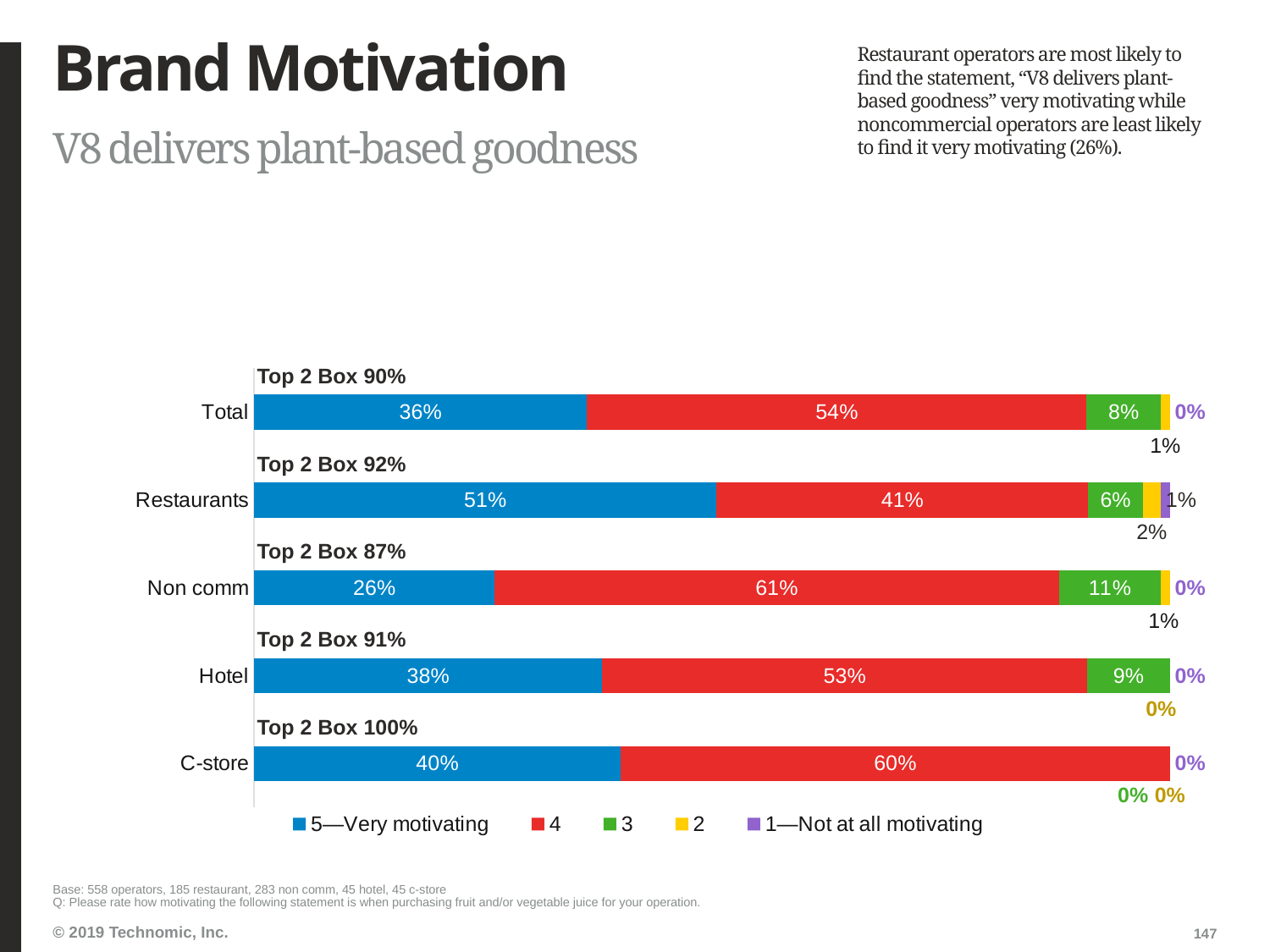
What percentage of Restaurants rated the statement 5—Very motivating? 51% What is the difference between the Top 2 Box values for C-store and Non comm? 13% How many series does the legend list? 5 What is the Top 2 Box value for Total? 90% What percentage of Non comm operators gave a rating of 4? 61% Which category has the lowest share of 5—Very motivating ratings? Non comm What kind of chart is shown on the slide? Stacked bar chart What is the Top 2 Box value for C-store? 100% Which category has the highest share of 5—Very motivating ratings? Restaurants Which is larger: the 5—Very motivating share for Hotel or for C-store? C-store How many categories are shown on the chart? 5 What percentage of Hotel operators gave a rating of 3? 9%